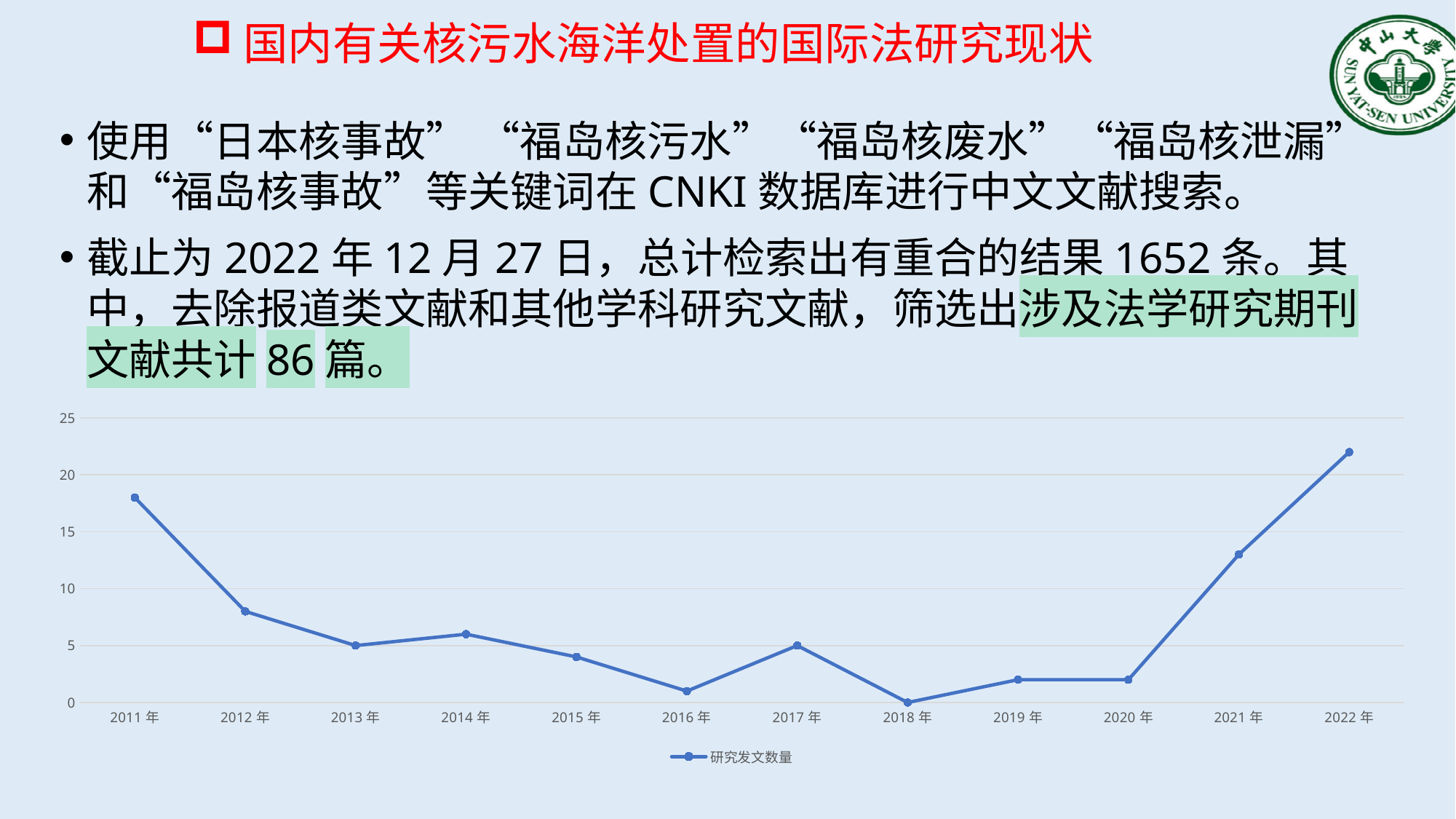
Which year has the lowest value in the chart? 2018 年 Is the value for 2022 年 greater or less than 20? greater How many series does the chart's legend list? 1 How many years are plotted on the x axis of the chart? 12 Which is larger, the value for 2012 年 or the value for 2021 年? 2021 年 What is the name of the series shown in the chart's legend? 研究发文数量 Do the values rise or fall from 2020 年 to 2022 年? rise What is the value for 2018 年 in the chart? 0 Which year has the highest value in the chart? 2022 年 Is the value for 2011 年 greater or less than 15? greater What kind of chart is shown on the slide? line chart Is the value for 2016 年 greater or less than 5? less